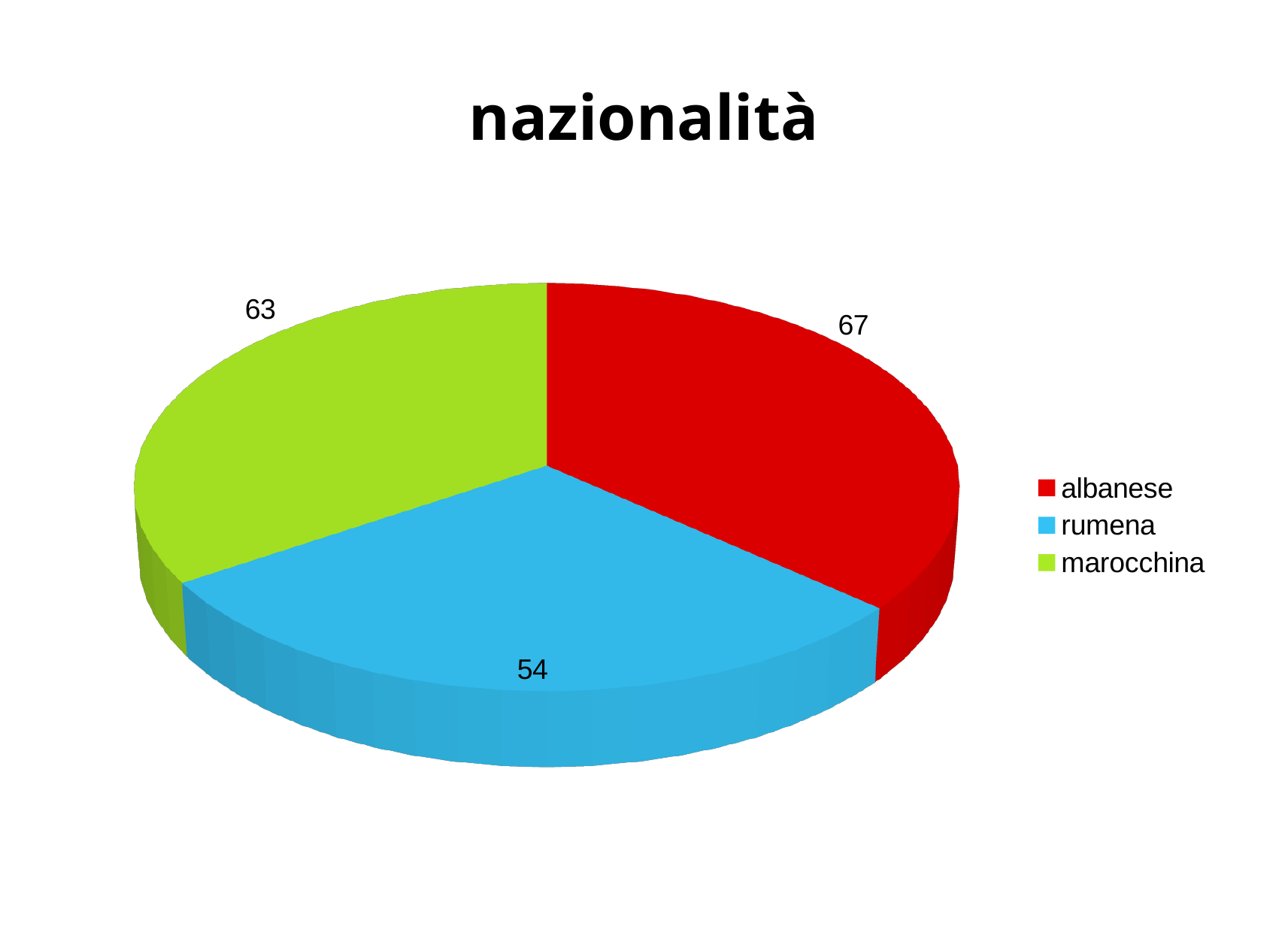
What is the difference between the values for albanese and marocchina? 4 What is the title of the chart? nazionalità What is the value for albanese? 67 What is the difference between the values for albanese and rumena? 13 What is the value for marocchina? 63 What type of chart is shown on the slide? pie chart Which nationality has the largest slice? albanese Which is larger, the value for marocchina or the value for rumena? marocchina What colour is the slice for rumena? blue Which nationality has the smallest slice? rumena What is the value for rumena? 54 How many slices does the pie chart have? 3